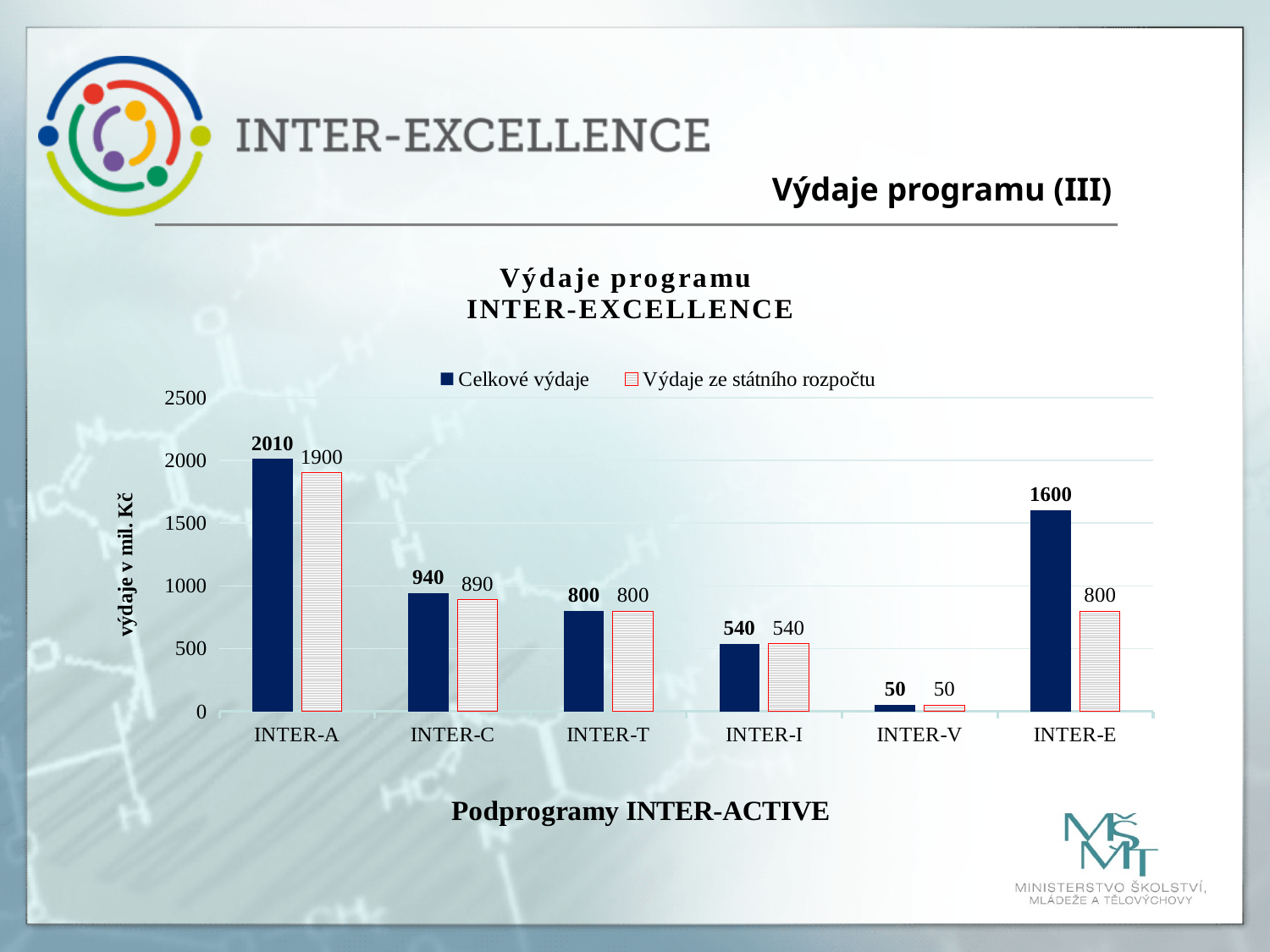
What is the value of Celkové výdaje for INTER-I? 540 What is the value of Celkové výdaje for INTER-A? 2010 What is the difference between Celkové výdaje for INTER-A and INTER-C? 1070 Which is larger: Celkové výdaje for INTER-C or for INTER-T? INTER-C How many subprograms are shown on the x axis? 6 What is the label of the vertical axis? výdaje v mil. Kč Which subprogram has the highest Celkové výdaje? INTER-A What is the value of Výdaje ze státního rozpočtu for INTER-E? 800 How many series does the legend list? 2 Which subprogram has the lowest Výdaje ze státního rozpočtu? INTER-V What is the difference between Celkové výdaje and Výdaje ze státního rozpočtu for INTER-E? 800 What kind of chart is shown on the slide? bar chart